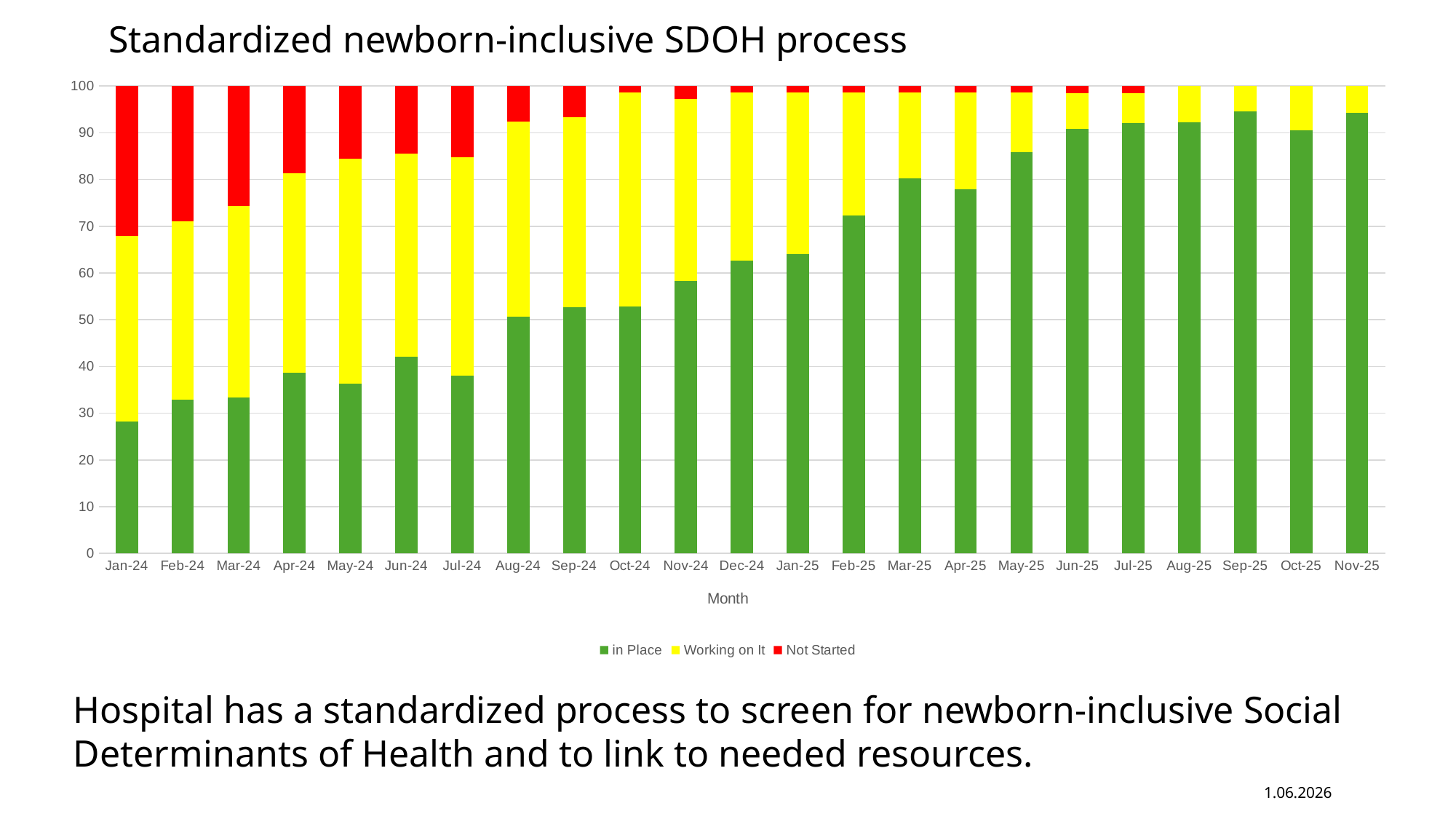
How many months are shown along the x axis? 23 Which month has the larger 'in Place' value, Jun-24 or Jul-24? Jun-24 What kind of chart is shown on the slide? Stacked bar chart Is the 'in Place' value for Nov-24 greater or less than 50? greater What is the title of the chart? Standardized newborn-inclusive SDOH process Is the 'in Place' value for May-25 greater or less than 80? greater How many series does the legend list? 3 Is the 'in Place' value for Apr-24 greater or less than 40? less Does the 'in Place' share generally rise or fall from Jan-24 to Nov-25? Rise In which month is the 'in Place' value lowest? Jan-24 In which month is the 'Not Started' value highest? Jan-24 Which series is shown in green in the legend? in Place